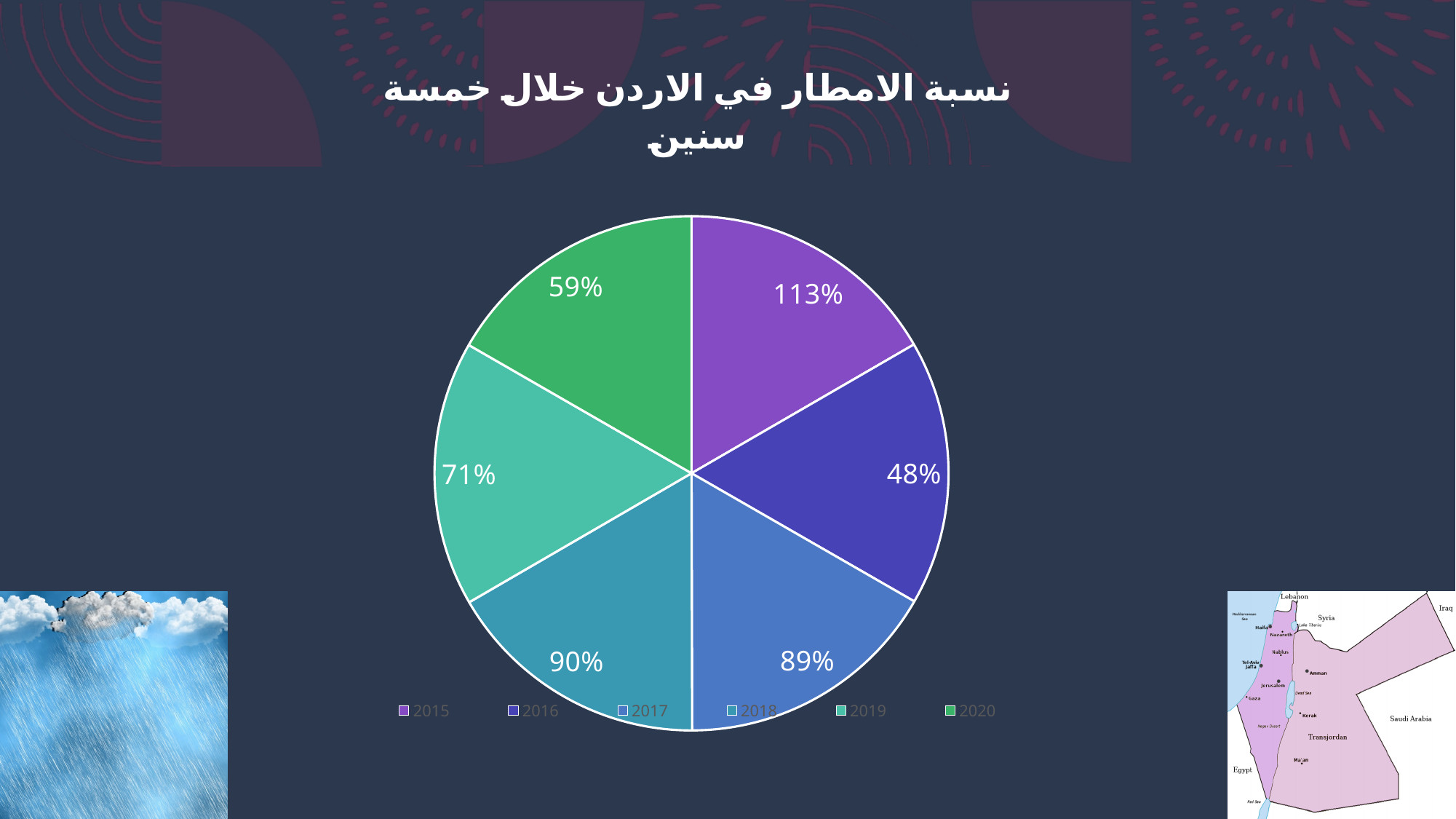
What is the value labelled on the slice for 2016? 48% Which year has the lowest labelled value? 2016 What is the value labelled on the slice for 2019? 71% Which year has the highest labelled value? 2015 What is the difference between the labelled values for 2015 and 2016? 65% How many slices does the pie chart have? 6 What kind of chart is shown on the slide? pie chart What is the value labelled on the slice for 2017? 89% How many entries does the legend list? 6 What is the value labelled on the slice for 2015? 113% What is the value labelled on the slice for 2020? 59% What is the value labelled on the slice for 2018? 90%